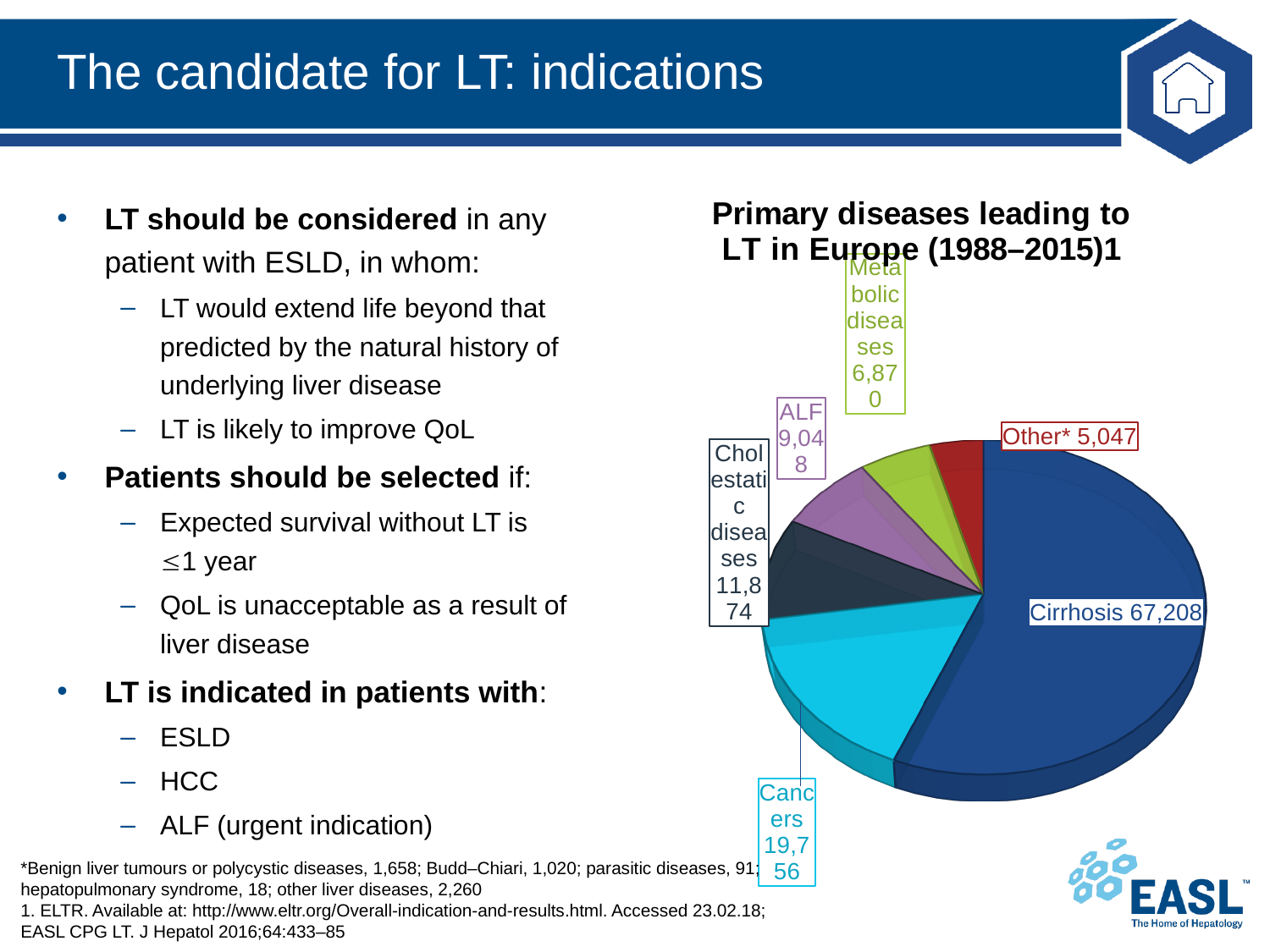
Which is larger, the value for ALF or the value for Metabolic diseases? ALF Which category has the largest slice of the pie? Cirrhosis How many slices does the pie chart have? 6 What is the value shown for Cancers? 19,756 What is the value shown for Metabolic diseases? 6,870 What is the value shown for ALF? 9,048 What is the title of the chart? Primary diseases leading to LT in Europe (1988–2015) What is the difference between the values for Cirrhosis and Cancers? 47,452 Which category has the smallest slice of the pie? Other* What kind of chart is shown on the slide? Pie chart What is the value shown for Cholestatic diseases? 11,874 What is the value shown for Cirrhosis? 67,208